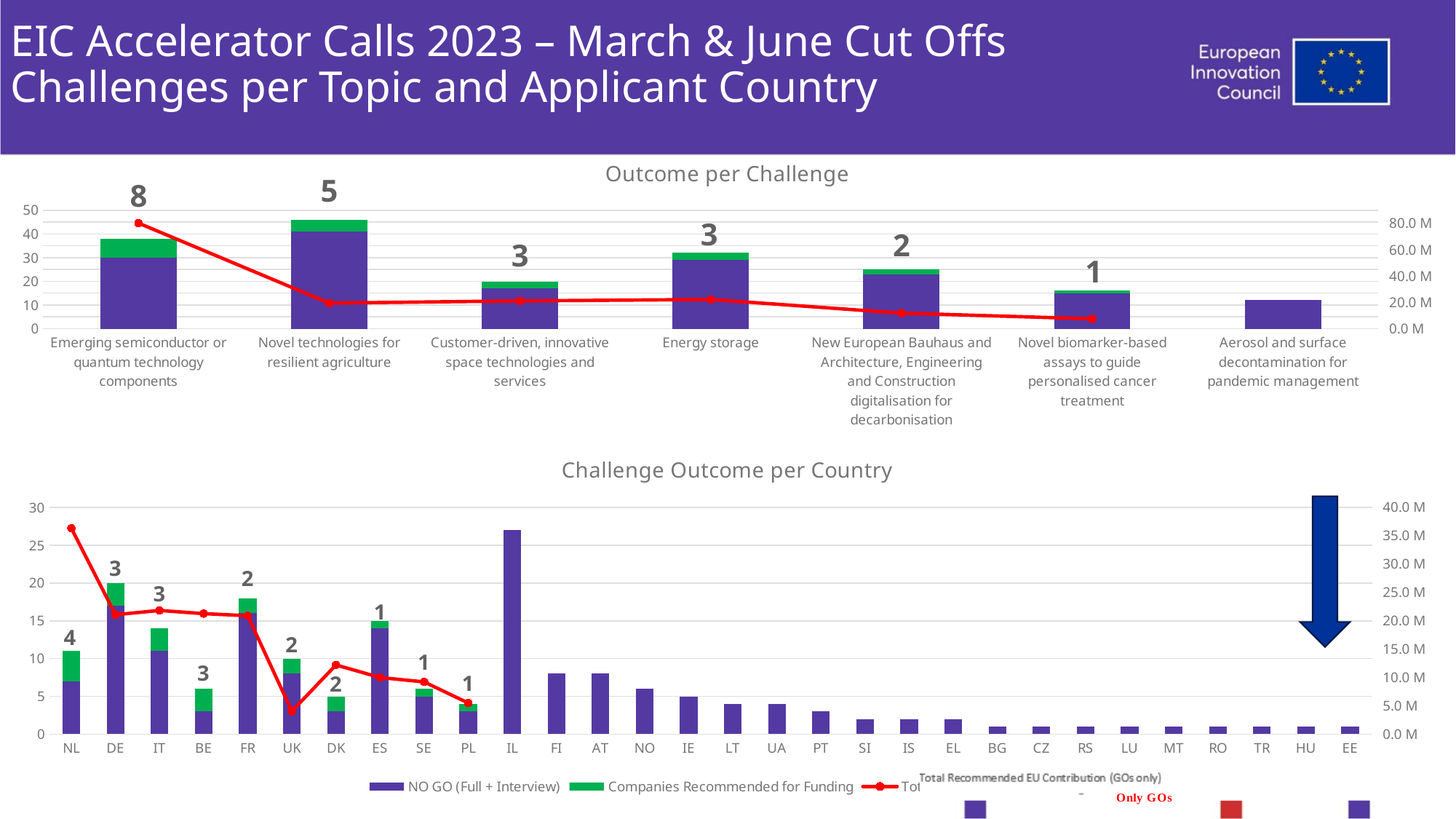
In the 'Outcome per Challenge' chart, is the bar for 'Aerosol and surface decontamination for pandemic management' greater or less than 20? less How many series does the legend of the 'Challenge Outcome per Country' chart list? 3 In the 'Outcome per Challenge' chart, what is the data label shown above the bar for 'Emerging semiconductor or quantum technology components'? 8 In the 'Challenge Outcome per Country' chart, what is the data label shown above the bar for NL? 4 In the 'Outcome per Challenge' chart, what is the difference between the labelled values for 'Emerging semiconductor or quantum technology components' and 'Novel technologies for resilient agriculture'? 3 In the 'Challenge Outcome per Country' chart, which country has the tallest bar? IL How many countries are shown on the x axis of the 'Challenge Outcome per Country' chart? 30 In the 'Outcome per Challenge' chart, which challenge has the highest labelled number of companies recommended for funding? Emerging semiconductor or quantum technology components In the 'Challenge Outcome per Country' chart, which has the larger labelled value, NL or FR? NL How many challenge categories are shown on the x axis of the 'Outcome per Challenge' chart? 7 In the 'Challenge Outcome per Country' chart, is the bar for IL greater or less than 25? greater In the 'Outcome per Challenge' chart, is the total bar height for 'Novel technologies for resilient agriculture' greater or less than 40? greater